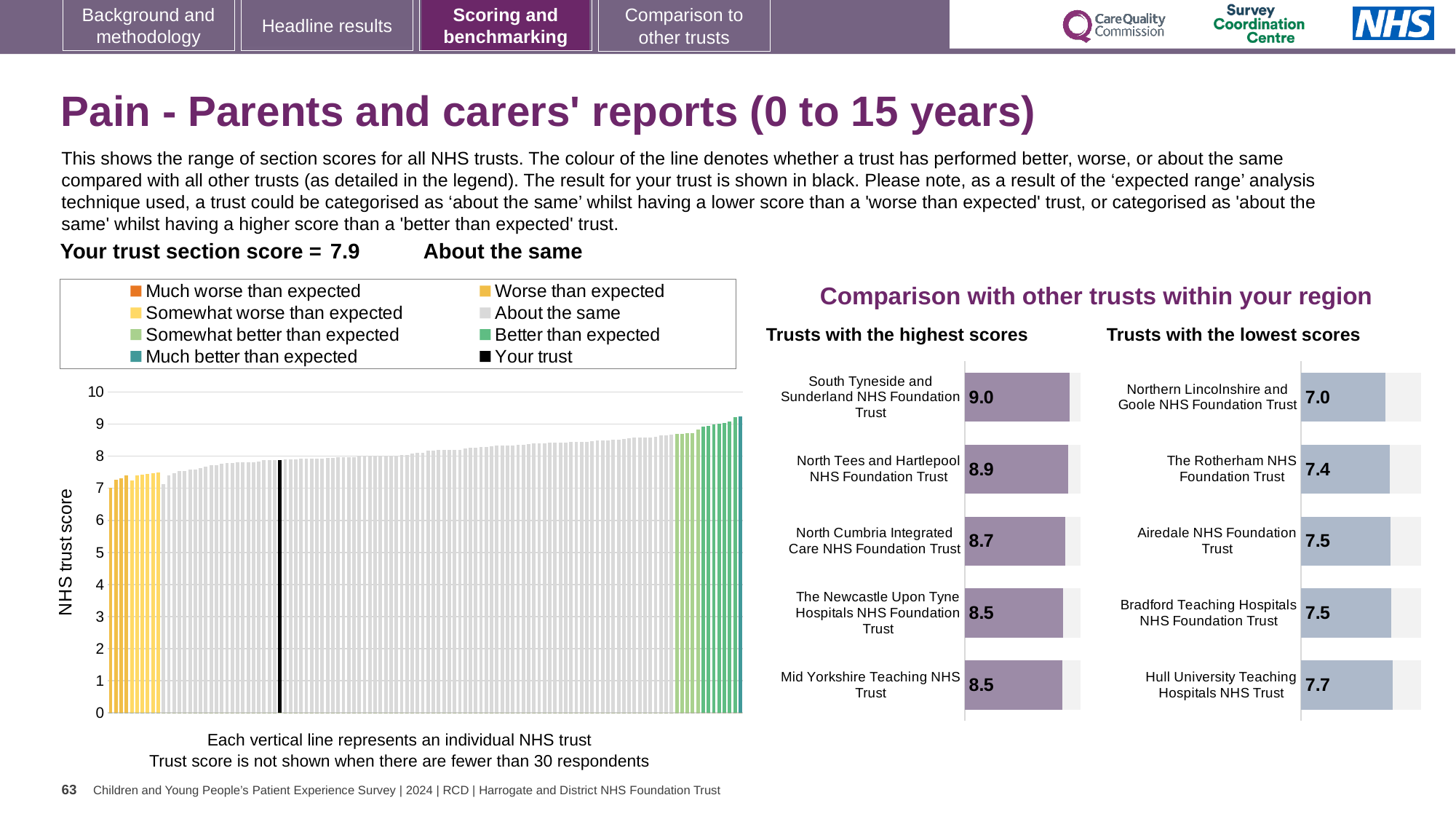
In the 'Trusts with the lowest scores' chart, what is the score for The Rotherham NHS Foundation Trust? 7.4 In the 'Trusts with the lowest scores' chart, which has the higher score: Airedale NHS Foundation Trust or Hull University Teaching Hospitals NHS Trust? Hull University Teaching Hospitals NHS Trust How many entries does the legend above the large chart on the left list? 8 In the large chart on the left, do the trust scores rise or fall from left to right? Rise In the 'Trusts with the lowest scores' chart, which trust has the lowest score? Northern Lincolnshire and Goole NHS Foundation Trust In the 'Trusts with the highest scores' chart, what is the score for North Cumbria Integrated Care NHS Foundation Trust? 8.7 In the 'Trusts with the highest scores' chart, what is the difference between the scores of South Tyneside and Sunderland NHS Foundation Trust and Mid Yorkshire Teaching NHS Trust? 0.5 In the 'Trusts with the lowest scores' chart, what is the difference between the scores of Hull University Teaching Hospitals NHS Trust and Northern Lincolnshire and Goole NHS Foundation Trust? 0.7 In the 'Trusts with the highest scores' chart, what is the score for South Tyneside and Sunderland NHS Foundation Trust? 9.0 How many trusts are listed in the 'Trusts with the lowest scores' chart? 5 In the 'Trusts with the highest scores' chart, which trust has the highest score? South Tyneside and Sunderland NHS Foundation Trust What kind of chart is the large chart on the left showing NHS trust scores? Bar chart